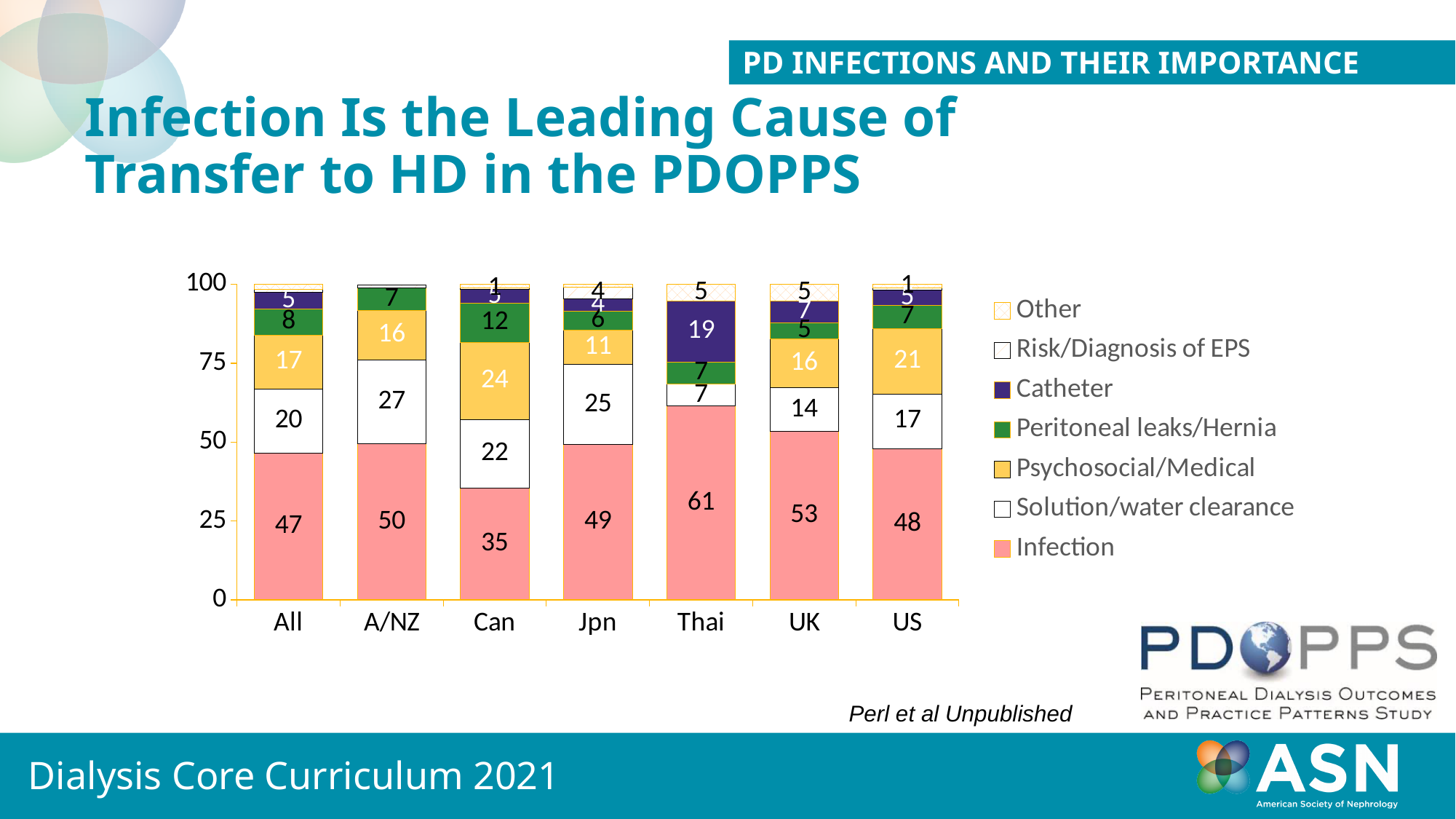
What is the difference between the Infection values for Thai and Can? 26 Which country has the highest Infection value? Thai What kind of chart is shown on the slide? Stacked bar chart What is the Peritoneal leaks/Hernia value for Can? 12 How many series does the legend list? 7 What is the Solution/water clearance value for A/NZ? 27 What is the Catheter value for Thai? 19 What is the Psychosocial/Medical value for Can? 24 Which country has the lowest Infection value? Can What is the Infection value for Thai? 61 How many categories are shown on the x axis? 7 Which has the larger Infection value, UK or US? UK